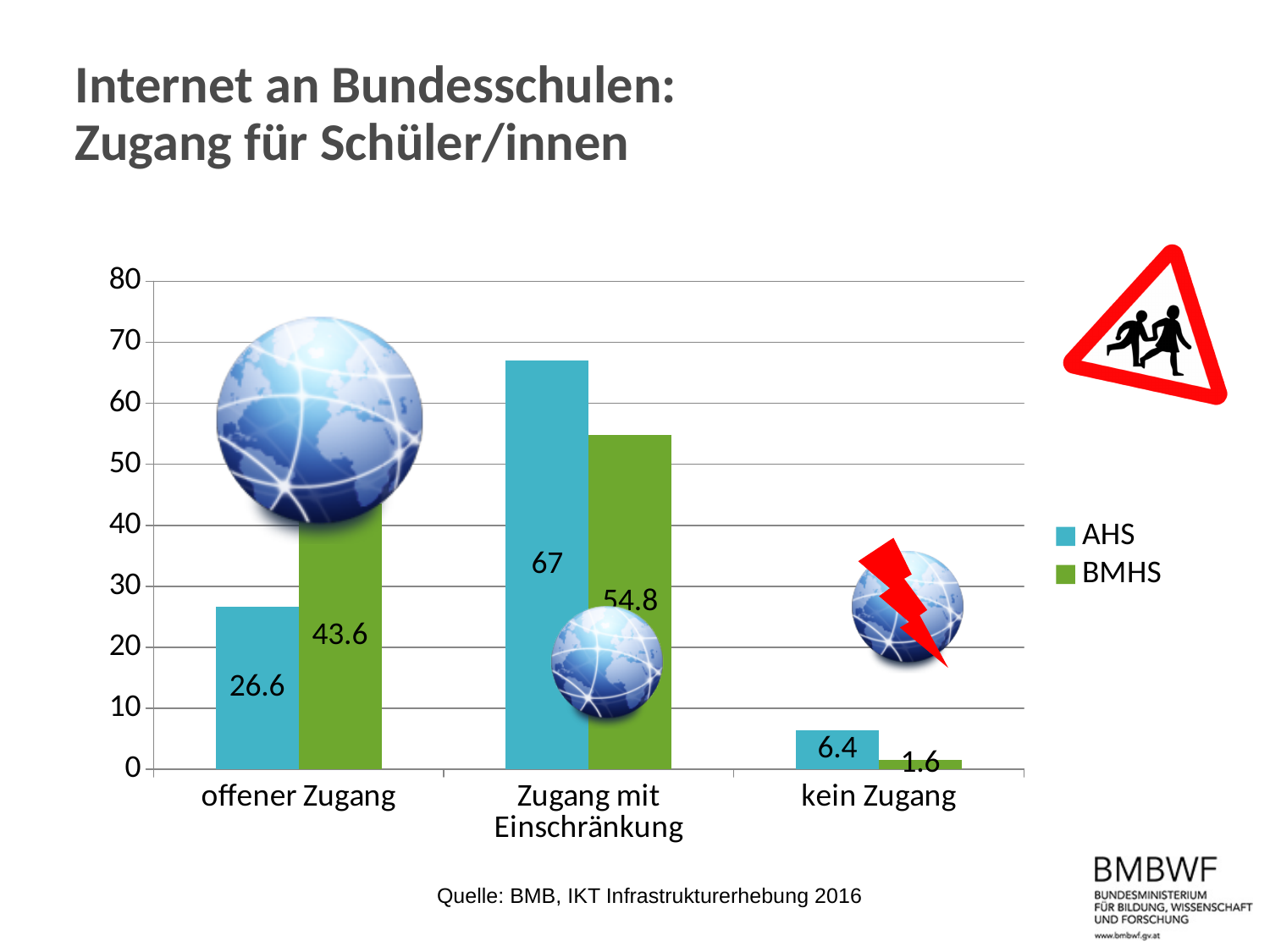
What kind of chart is shown on the slide? bar chart How many categories are shown on the x axis? 3 What is the difference between the AHS and BMHS values for "Zugang mit Einschränkung"? 12.2 What is the BMHS value for "Zugang mit Einschränkung"? 54.8 Which category has the highest AHS value? Zugang mit Einschränkung What is the difference between the BMHS and AHS values for "offener Zugang"? 17 What is the AHS value for "offener Zugang"? 26.6 What is the BMHS value for "kein Zugang"? 1.6 How many series does the legend list? 2 For "offener Zugang", which series has the larger value, AHS or BMHS? BMHS Is the AHS value for "Zugang mit Einschränkung" greater or less than 60? greater Which category has the lowest BMHS value? kein Zugang